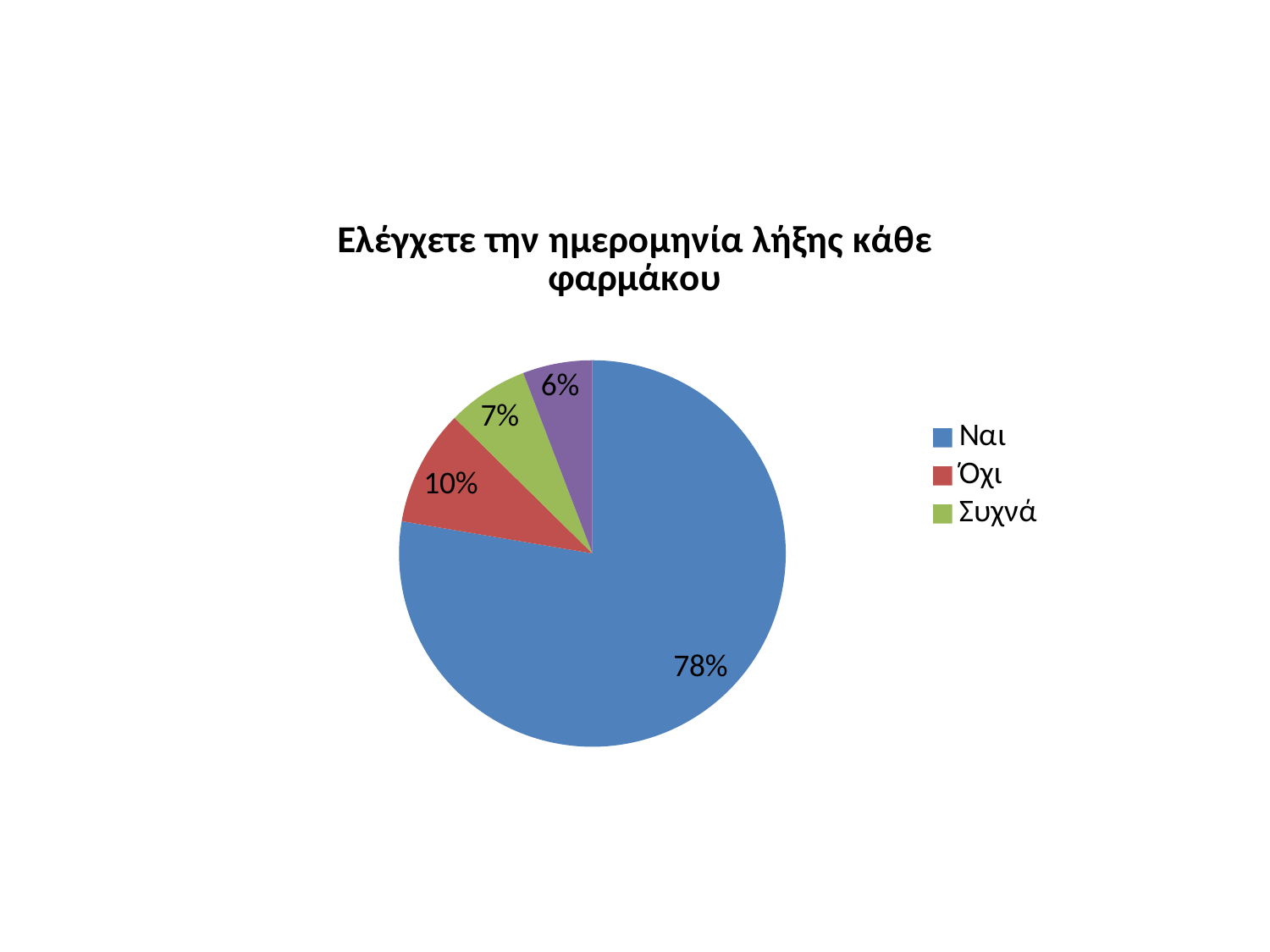
What is the difference in percentage points between the Ναι slice and the Όχι slice? 68 What kind of chart is shown on the slide? pie chart How many entries does the legend list? 3 Which of the legend categories has the smallest slice of the pie? Συχνά What percentage of the pie does the Ναι slice represent? 78% What percentage of the pie does the Όχι slice represent? 10% What percentage of the pie does the Συχνά slice represent? 7% Which category has the largest slice of the pie? Ναι How many slices does the pie chart have? 4 Which slice is larger, Όχι or Συχνά? Όχι What is the title of the chart? Ελέγχετε την ημερομηνία λήξης κάθε φαρμάκου What is the difference in percentage points between the Όχι slice and the Συχνά slice? 3